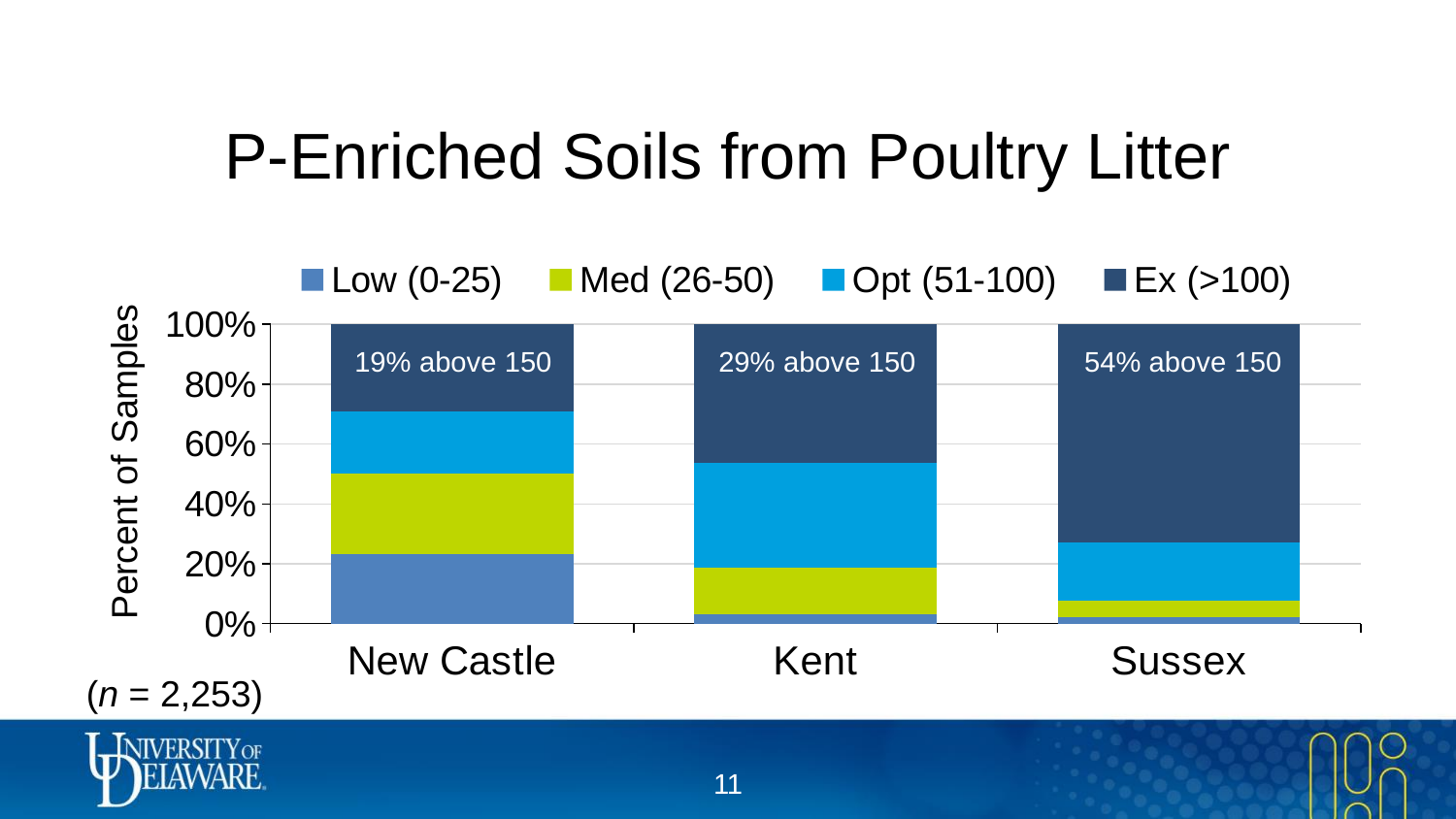
Which county has the highest percentage of samples above 150? Sussex What percentage of Kent samples are above 150, according to the label on the bar? 29% Is the Ex (>100) share for Sussex greater or less than 60%? greater Which county has the lowest percentage of samples above 150? New Castle Is the Low (0-25) share for New Castle greater or less than 20%? greater How many series does the legend list? 4 How many counties are shown on the x axis? 3 What percentage of Sussex samples are above 150, according to the label on the bar? 54% What kind of chart is shown on the slide? Stacked bar chart What is the difference between the percentage of samples above 150 in Sussex and in New Castle? 35 percentage points Which county has a larger percentage of samples above 150, Kent or New Castle? Kent What percentage of New Castle samples are above 150, according to the label on the bar? 19%